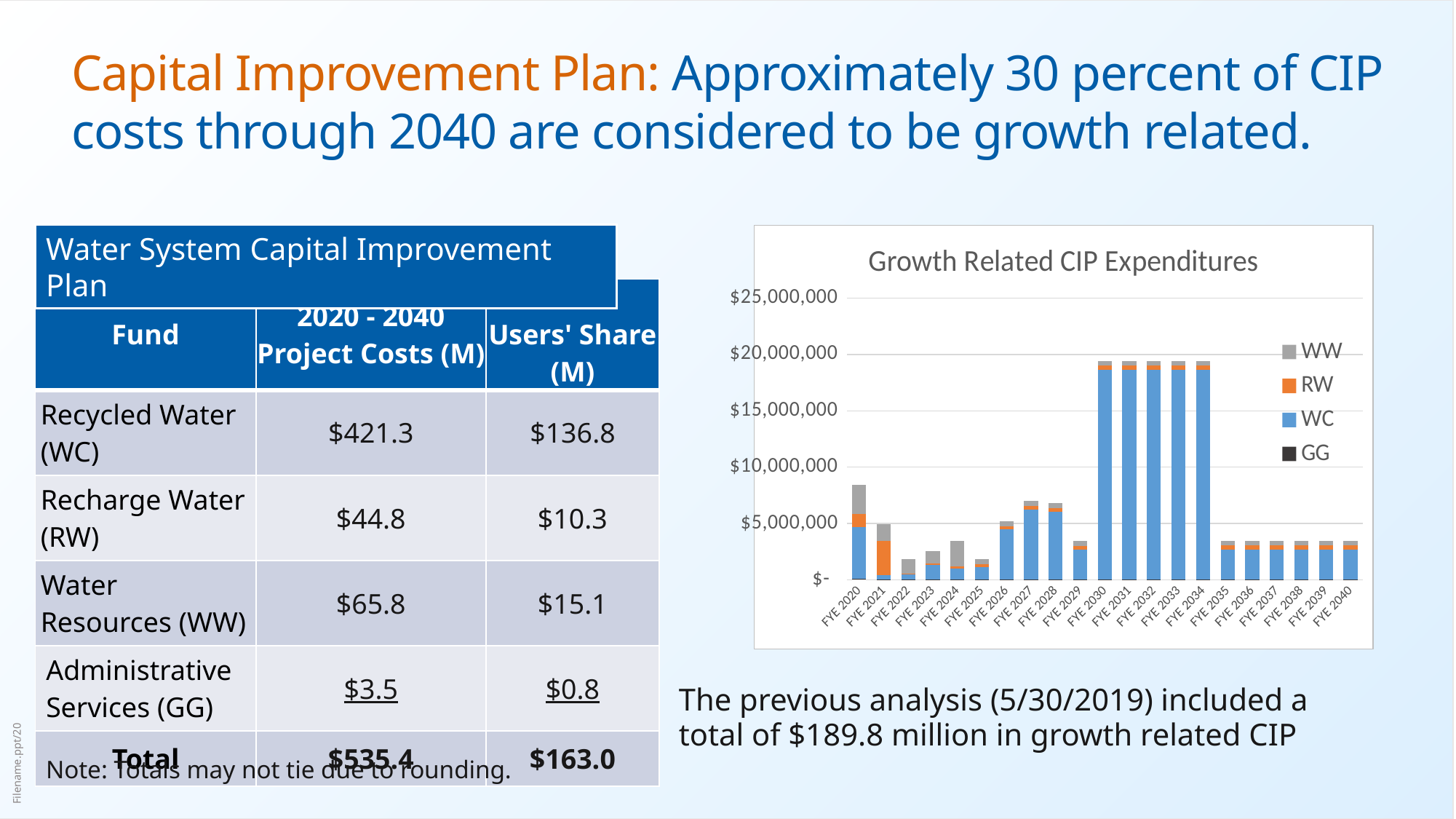
In the Growth Related CIP Expenditures chart, which has the larger total bar, FYE 2031 or FYE 2036? FYE 2031 In the Growth Related CIP Expenditures chart, which has the larger total bar, FYE 2020 or FYE 2021? FYE 2020 What is the title of the chart on the slide? Growth Related CIP Expenditures In the Growth Related CIP Expenditures chart, is the total value for FYE 2020 greater or less than $5,000,000? greater How many series does the legend of the Growth Related CIP Expenditures chart list? 4 In the Growth Related CIP Expenditures chart, which legend series is shown in blue? WC In the Growth Related CIP Expenditures chart, is the total value for FYE 2022 greater or less than $5,000,000? less In the Growth Related CIP Expenditures chart, is the total value for FYE 2030 greater or less than $15,000,000? greater How many fiscal years (categories) are shown on the x axis of the Growth Related CIP Expenditures chart? 21 In the Growth Related CIP Expenditures chart, which has the larger total bar, FYE 2027 or FYE 2029? FYE 2027 What kind of chart is the Growth Related CIP Expenditures chart? Stacked bar chart